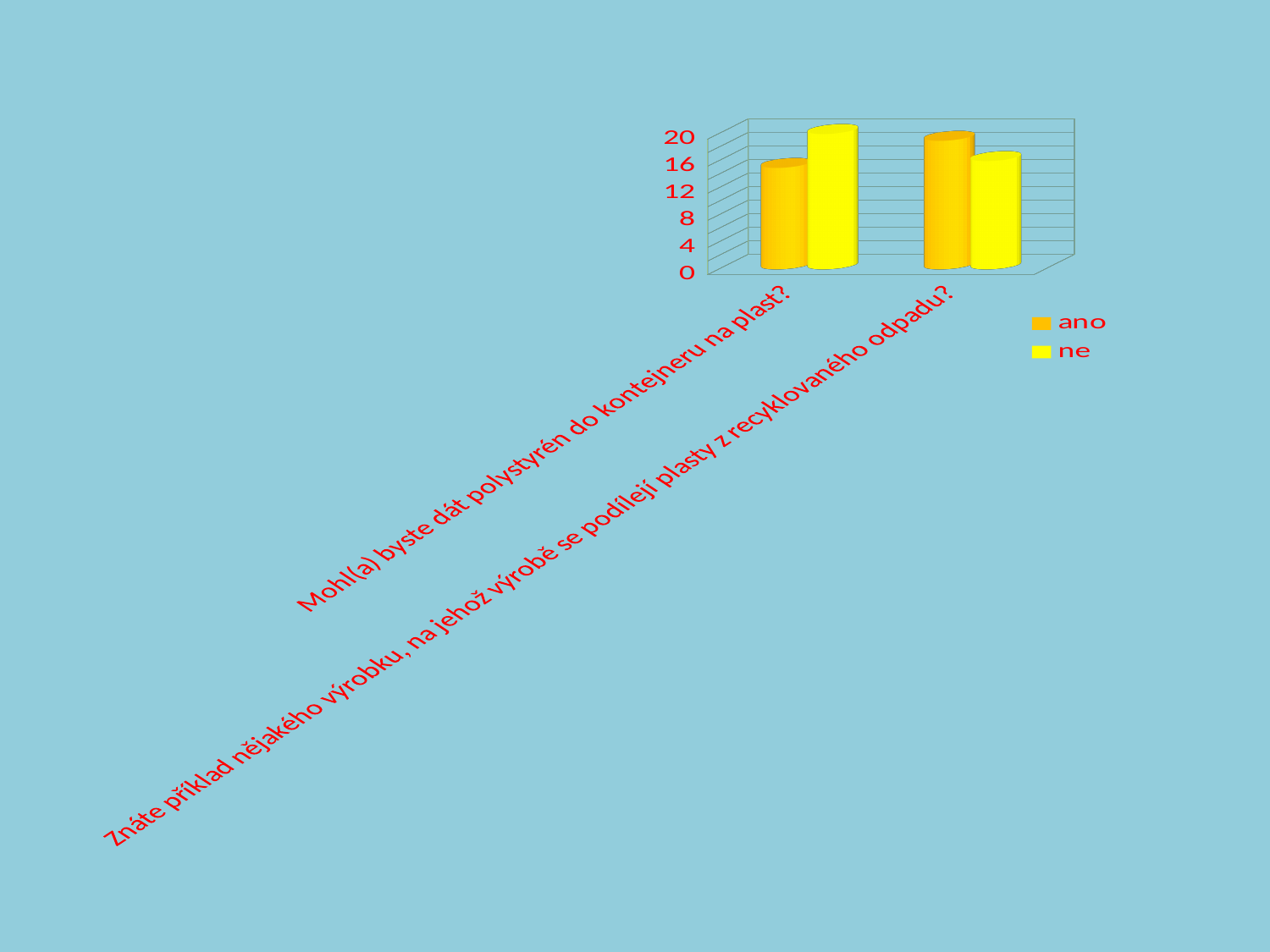
What are the two series named in the legend? ano, ne Is the "ano" value for "Mohl(a) byste dát polystyrén do kontejneru na plast?" greater or less than 12? greater How many question categories are shown on the x axis? 2 Which colour represents the series "ano"? orange For "Mohl(a) byste dát polystyrén do kontejneru na plast?", which is larger, "ano" or "ne"? ne What kind of chart is shown on the slide? bar chart Is the "ne" value for "Mohl(a) byste dát polystyrén do kontejneru na plast?" greater or less than 16? greater Is the "ano" value for "Znáte příklad nějakého výrobku, na jehož výrobě se podílejí plasty z recyklovaného odpadu?" greater or less than 16? greater How many series does the legend list? 2 For "Znáte příklad nějakého výrobku, na jehož výrobě se podílejí plasty z recyklovaného odpadu?", which is larger, "ano" or "ne"? ano Which bar is the tallest in the chart? "ne" for "Mohl(a) byste dát polystyrén do kontejneru na plast?"